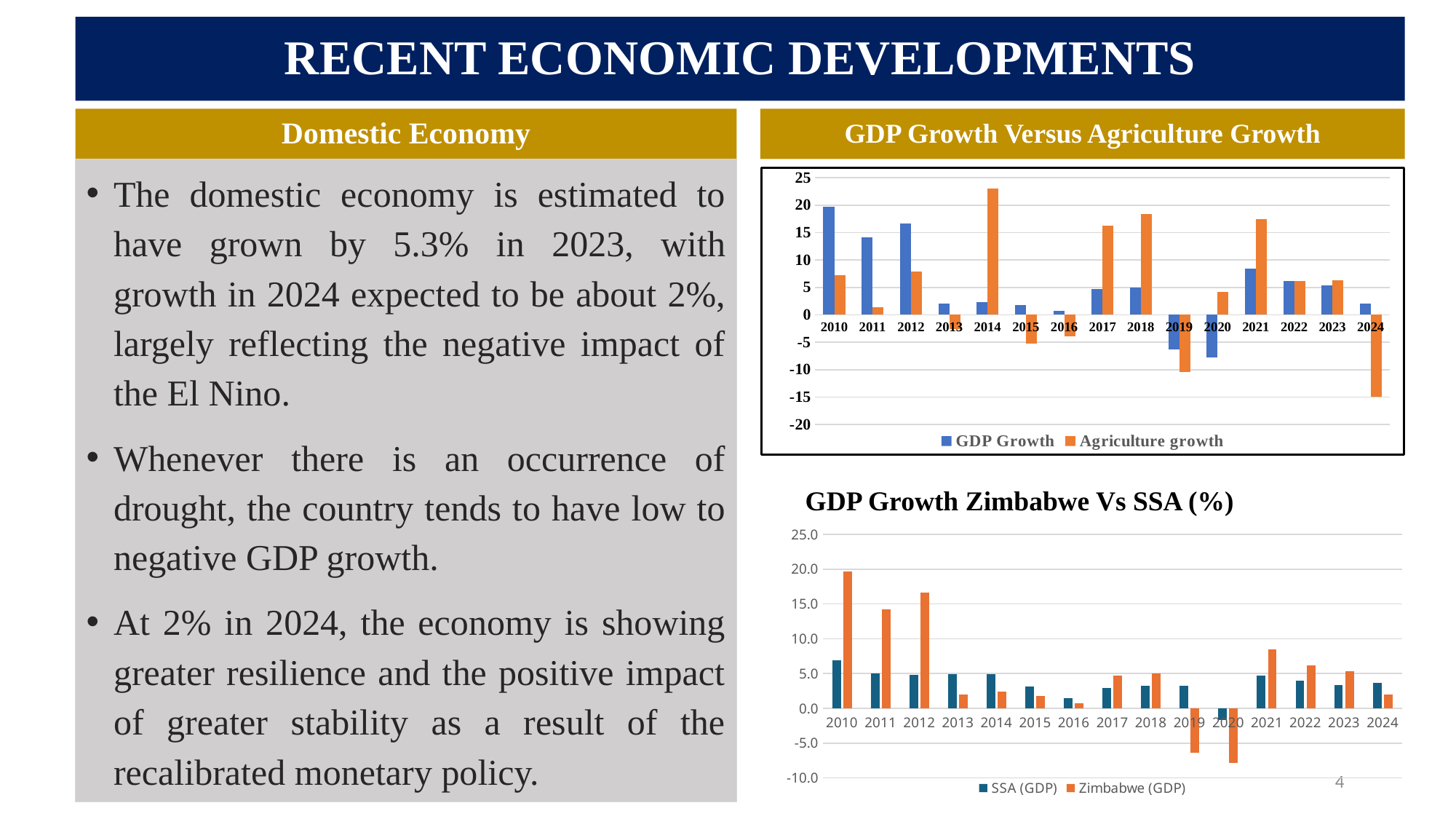
In the 'GDP Growth Versus Agriculture Growth' chart, is the Agriculture growth value for 2014 greater or less than 20? greater How many years are shown on the x axis of the 'GDP Growth Zimbabwe Vs SSA (%)' chart? 15 In the 'GDP Growth Versus Agriculture Growth' chart, which year has the lowest Agriculture growth? 2024 In the 'GDP Growth Versus Agriculture Growth' chart, which year has the highest Agriculture growth? 2014 How many series does the legend of the 'GDP Growth Versus Agriculture Growth' chart list? 2 What kind of chart is the 'GDP Growth Zimbabwe Vs SSA (%)' chart? Bar chart In the 'GDP Growth Versus Agriculture Growth' chart, which year has the highest GDP Growth? 2010 In the 'GDP Growth Zimbabwe Vs SSA (%)' chart, which is larger in 2015, SSA (GDP) or Zimbabwe (GDP)? SSA (GDP) In the 'GDP Growth Zimbabwe Vs SSA (%)' chart, is the Zimbabwe (GDP) value for 2012 greater or less than 15.0? greater In the 'GDP Growth Versus Agriculture Growth' chart, which is larger in 2017, GDP Growth or Agriculture growth? Agriculture growth In the 'GDP Growth Zimbabwe Vs SSA (%)' chart, which year has the highest Zimbabwe (GDP) value? 2010 In the 'GDP Growth Versus Agriculture Growth' chart, is the Agriculture growth value for 2024 greater or less than -10? less